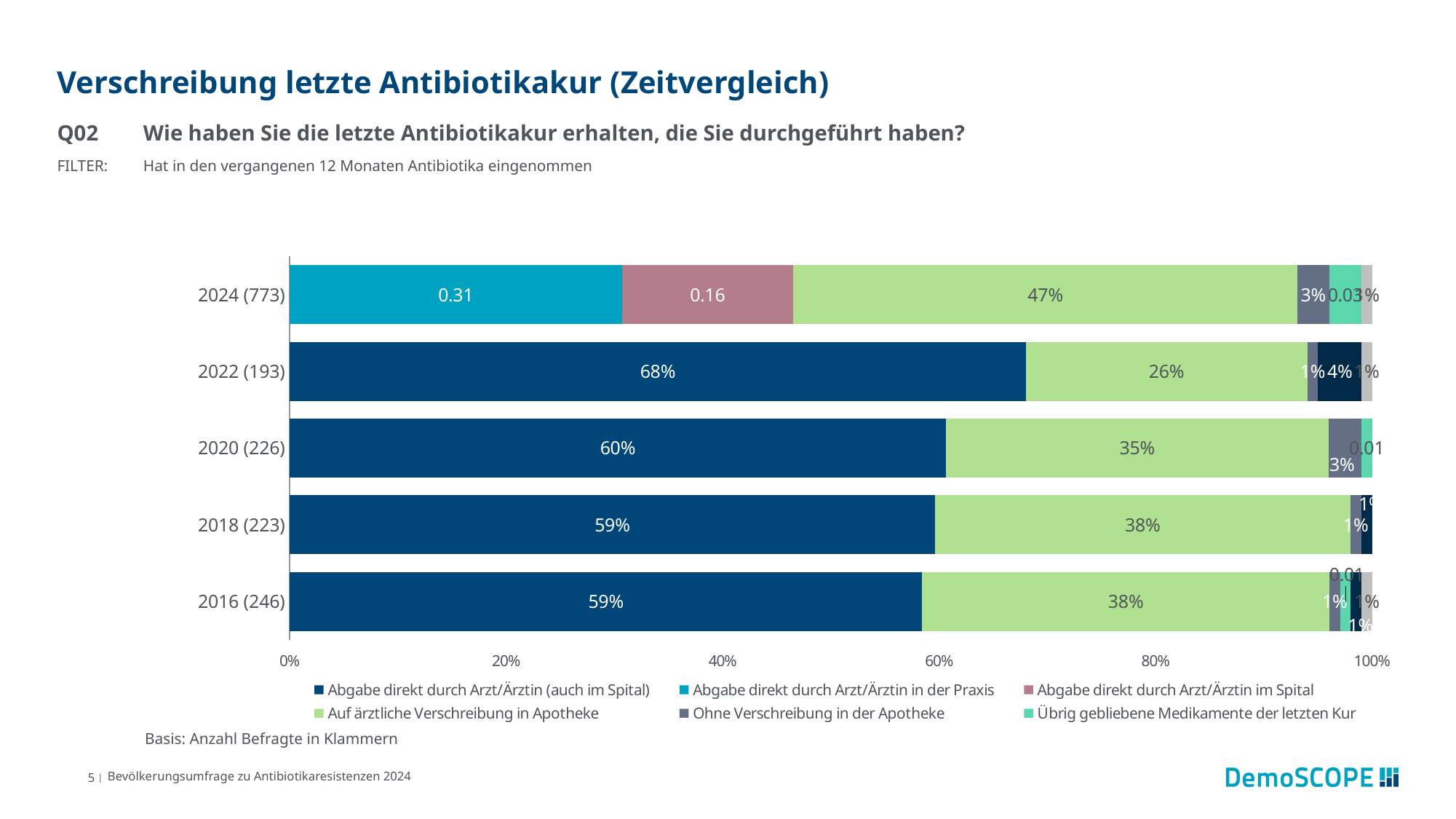
How many series does the legend list? 6 Which year has the lowest value for 'Auf ärztliche Verschreibung in Apotheke'? 2022 (193) How many years (categories) are shown on the chart? 5 What is the value for 'Abgabe direkt durch Arzt/Ärztin in der Praxis' in 2024 (773)? 0.31 What is the value for 'Auf ärztliche Verschreibung in Apotheke' in 2024 (773)? 47% What is the value for 'Abgabe direkt durch Arzt/Ärztin im Spital' in 2024 (773)? 0.16 Which year has the highest value for 'Abgabe direkt durch Arzt/Ärztin (auch im Spital)'? 2022 (193) What is the value for 'Abgabe direkt durch Arzt/Ärztin (auch im Spital)' in 2022 (193)? 68% What is the value for 'Auf ärztliche Verschreibung in Apotheke' in 2020 (226)? 35% What is the difference between the 'Auf ärztliche Verschreibung in Apotheke' values for 2024 (773) and 2022 (193)? 21 percentage points Which is larger: the 'Auf ärztliche Verschreibung in Apotheke' value for 2018 (223) or for 2020 (226)? 2018 (223) What kind of chart is shown on the slide? Stacked bar chart